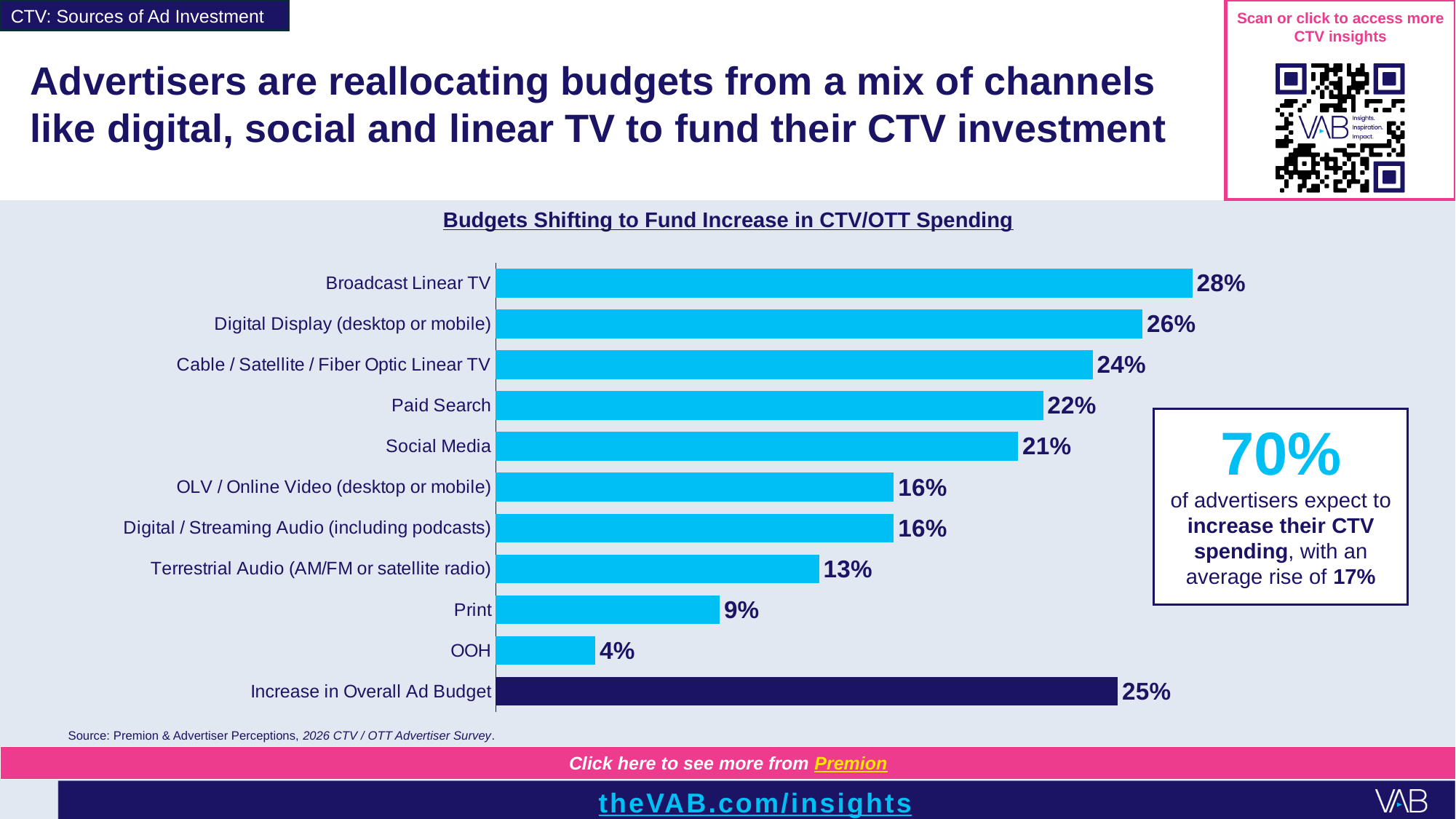
What is the value for Increase in Overall Ad Budget? 25% Which category has the highest value? Broadcast Linear TV Which category has the lowest value? OOH How many categories are shown in the chart? 11 What is the difference between Digital Display (desktop or mobile) and Print? 17% What is the value for Paid Search? 22% What is the value for Terrestrial Audio (AM/FM or satellite radio)? 13% Which bar is shown in a different (dark navy) colour from the others? Increase in Overall Ad Budget Which is larger, Social Media or Cable / Satellite / Fiber Optic Linear TV? Cable / Satellite / Fiber Optic Linear TV What kind of chart is shown on the slide? Bar chart What is the title of the chart? Budgets Shifting to Fund Increase in CTV/OTT Spending What is the value for Broadcast Linear TV? 28%